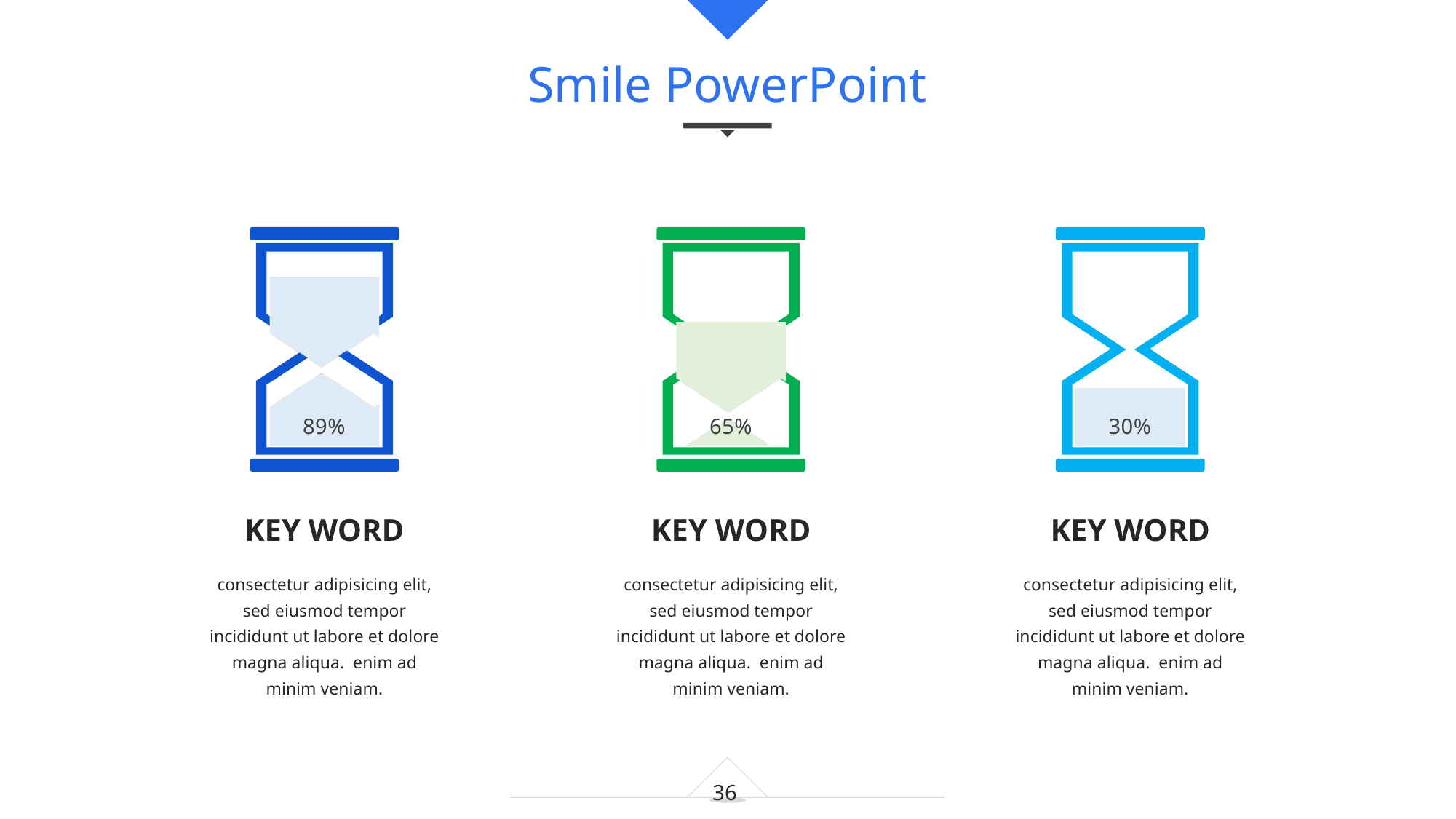
Do the percentages rise or fall from left to right across the three hourglasses? Fall What percentage is shown in the left (dark blue) hourglass? 89% Which hourglass shows the highest percentage? The left (dark blue) hourglass, 89% How many hourglass graphics with percentages are shown on the slide? 3 What is the title of the slide? Smile PowerPoint Which hourglass shows the lowest percentage? The right (light blue) hourglass, 30% What colour is the hourglass showing 65%? Green What is the difference between the percentages in the left and middle hourglasses? 24% What percentage is shown in the right (light blue) hourglass? 30% What is the difference between the percentages in the left and right hourglasses? 59% Which is larger, the percentage in the middle hourglass or the right hourglass? The middle hourglass (65%) What percentage is shown in the middle (green) hourglass? 65%